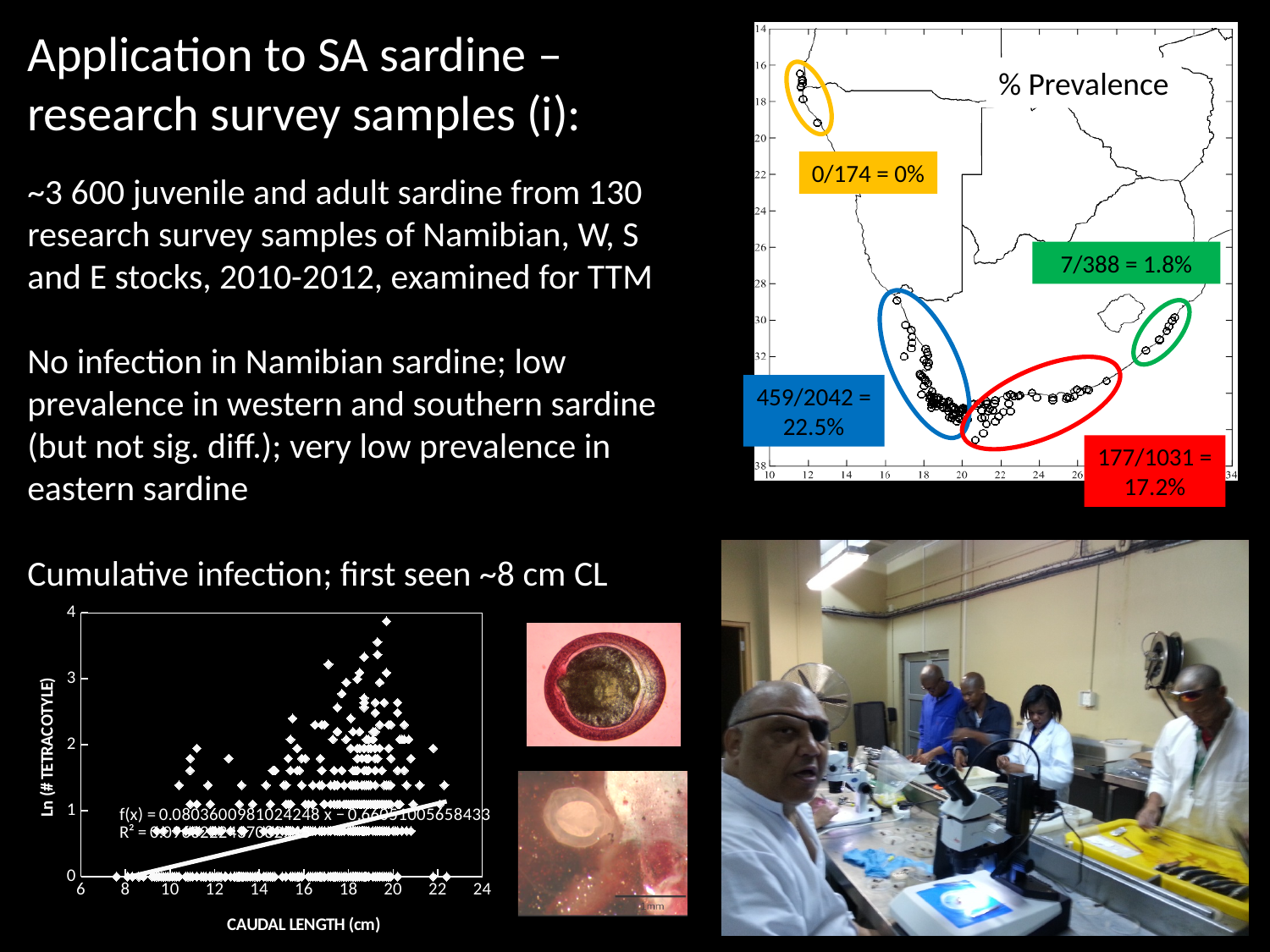
In the scatter chart at the bottom left, what is the highest tick value shown on the y axis? 4 In the scatter chart at the bottom left, is the highest plotted point greater or less than 3 on the y axis? greater In the scatter chart at the bottom left, what is the highest tick value shown on the x axis? 24 In the scatter chart at the bottom left, what is the lowest tick value shown on the x axis? 6 In the scatter chart at the bottom left, does the fitted trend line rise or fall as caudal length increases? rise On the map at the top right, what prevalence is printed in the yellow box for the Namibian samples? 0/174 = 0% In the scatter chart at the bottom left, what is the title of the y axis? Ln (# TETRACOTYLE) What kind of chart is the chart at the bottom left of the slide (Ln (# TETRACOTYLE) vs CAUDAL LENGTH)? scatter chart On the map at the top right, what prevalence is printed in the green box for the eastern samples? 7/388 = 1.8% On the map at the top right, what prevalence is printed in the blue box for the western samples? 459/2042 = 22.5% In the scatter chart at the bottom left, what is the title of the x axis? CAUDAL LENGTH (cm) On the map at the top right, which region has the highest printed prevalence: the blue (western) or the red (southern) region? blue (western), 22.5%